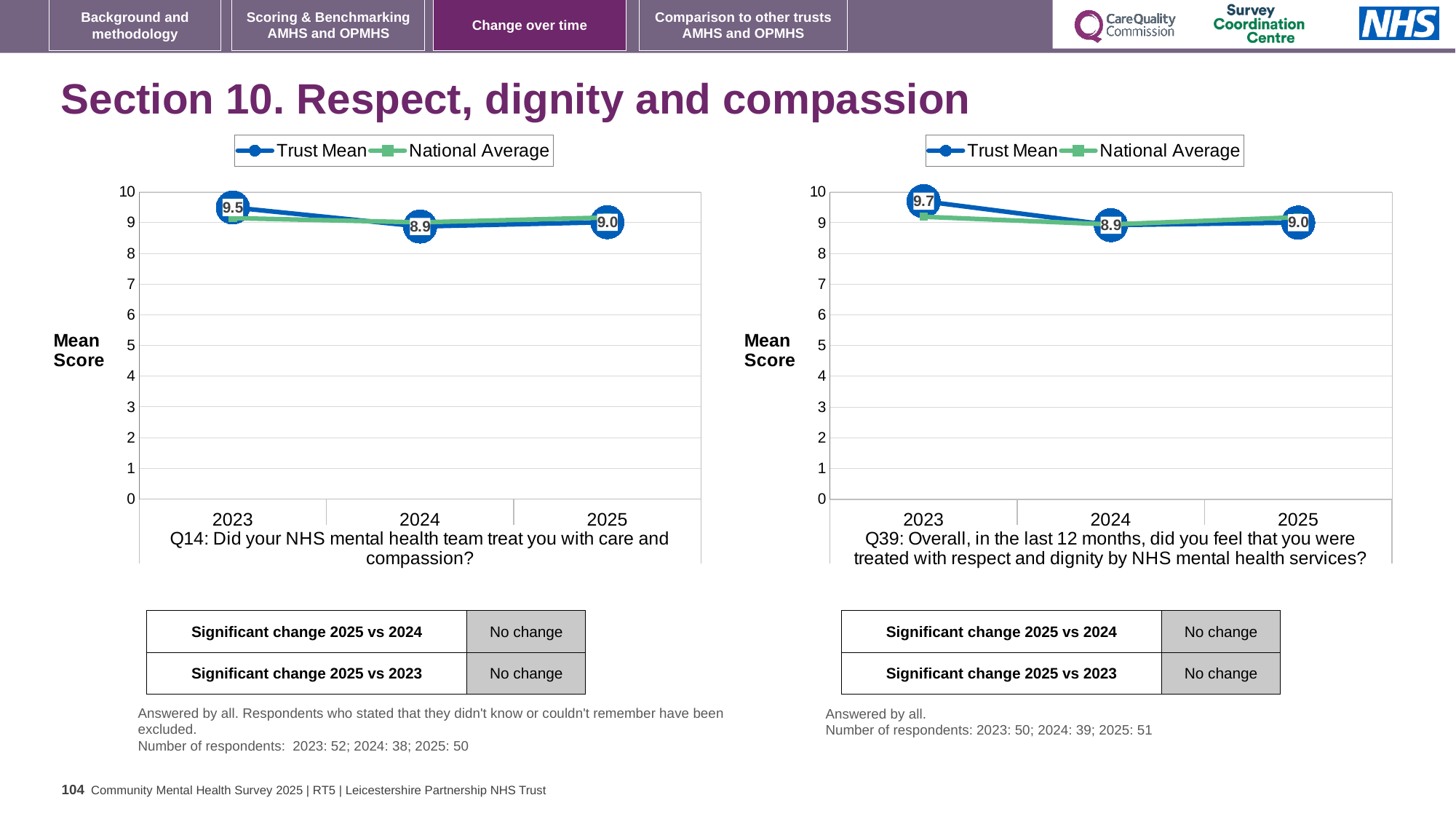
On the Q14 chart (left), what is the Trust Mean for 2023? 9.5 On the Q39 chart (right), what is the Trust Mean for 2025? 9.0 On the Q14 chart (left), in which year is the Trust Mean highest? 2023 How many series does the legend of the Q14 chart (left) list? 2 How many years are shown on the x axis of the Q39 chart (right)? 3 On the Q39 chart (right), what is the difference between the Trust Mean in 2023 and in 2025? 0.7 On the Q14 chart (left), is the National Average for 2023 greater or less than 8? greater On the Q14 chart (left), is the Trust Mean larger in 2023 or in 2025? 2023 On the Q14 chart (left), what is the Trust Mean for 2024? 8.9 On the Q39 chart (right), what is the Trust Mean for 2023? 9.7 On the Q39 chart (right), in which year is the Trust Mean lowest? 2024 What kind of chart is the Q39 chart (right)? Line chart